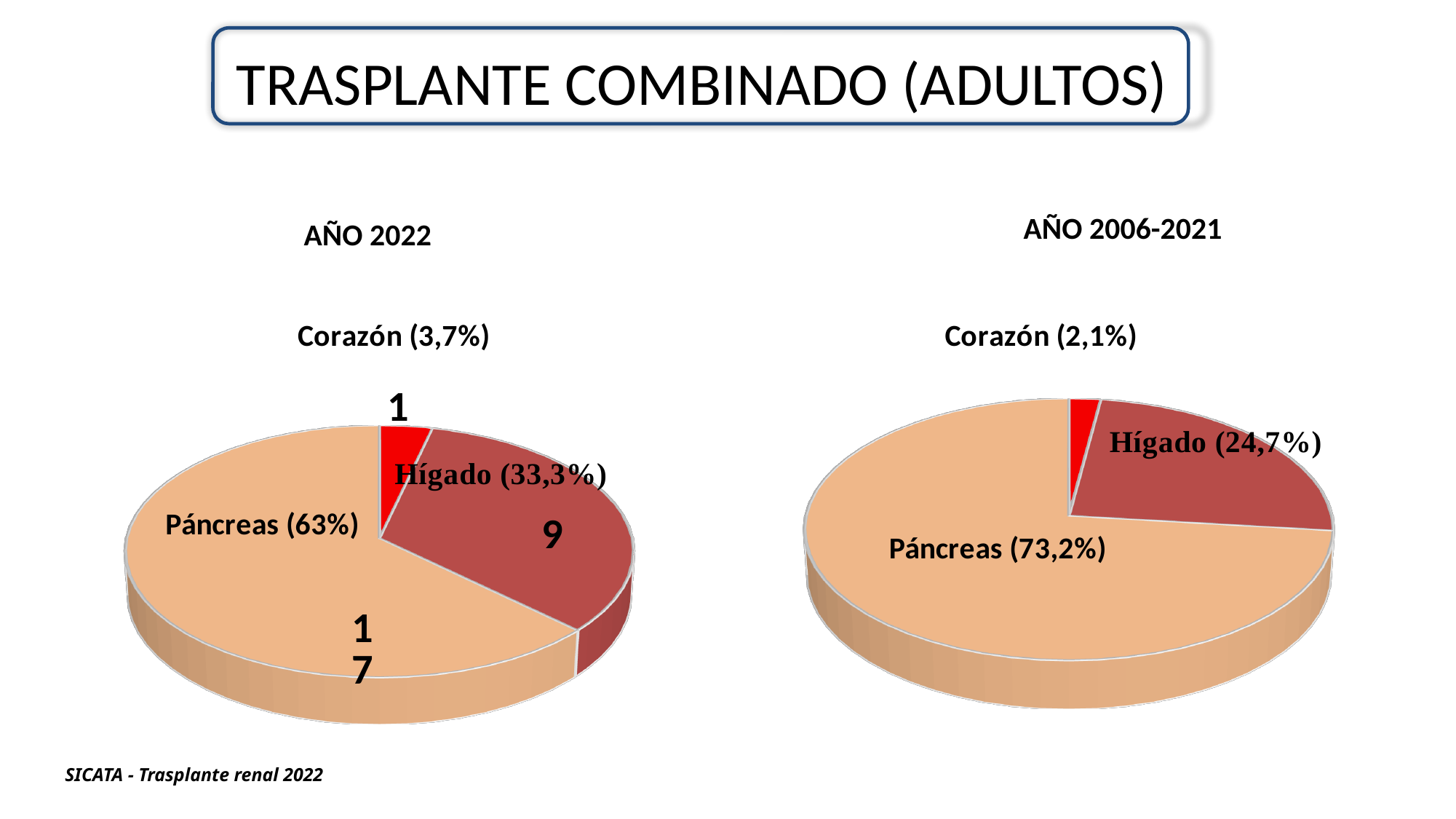
What kind of chart is used for AÑO 2022? Pie chart In the AÑO 2022 chart, what share of the pie does Corazón have? 3,7% In the AÑO 2022 chart, how many transplants are labelled for Páncreas? 17 In the AÑO 2022 chart, which category has the largest slice? Páncreas In the AÑO 2022 chart, what share of the pie does Páncreas have? 63% In the AÑO 2006-2021 chart, what share of the pie does Hígado have? 24,7% In the AÑO 2006-2021 chart, which category has the smallest slice? Corazón In the AÑO 2022 chart, what is the difference in count between Páncreas and Hígado? 8 How many slices does the AÑO 2006-2021 pie chart have? 3 In the AÑO 2022 chart, how many transplants are labelled for Hígado? 9